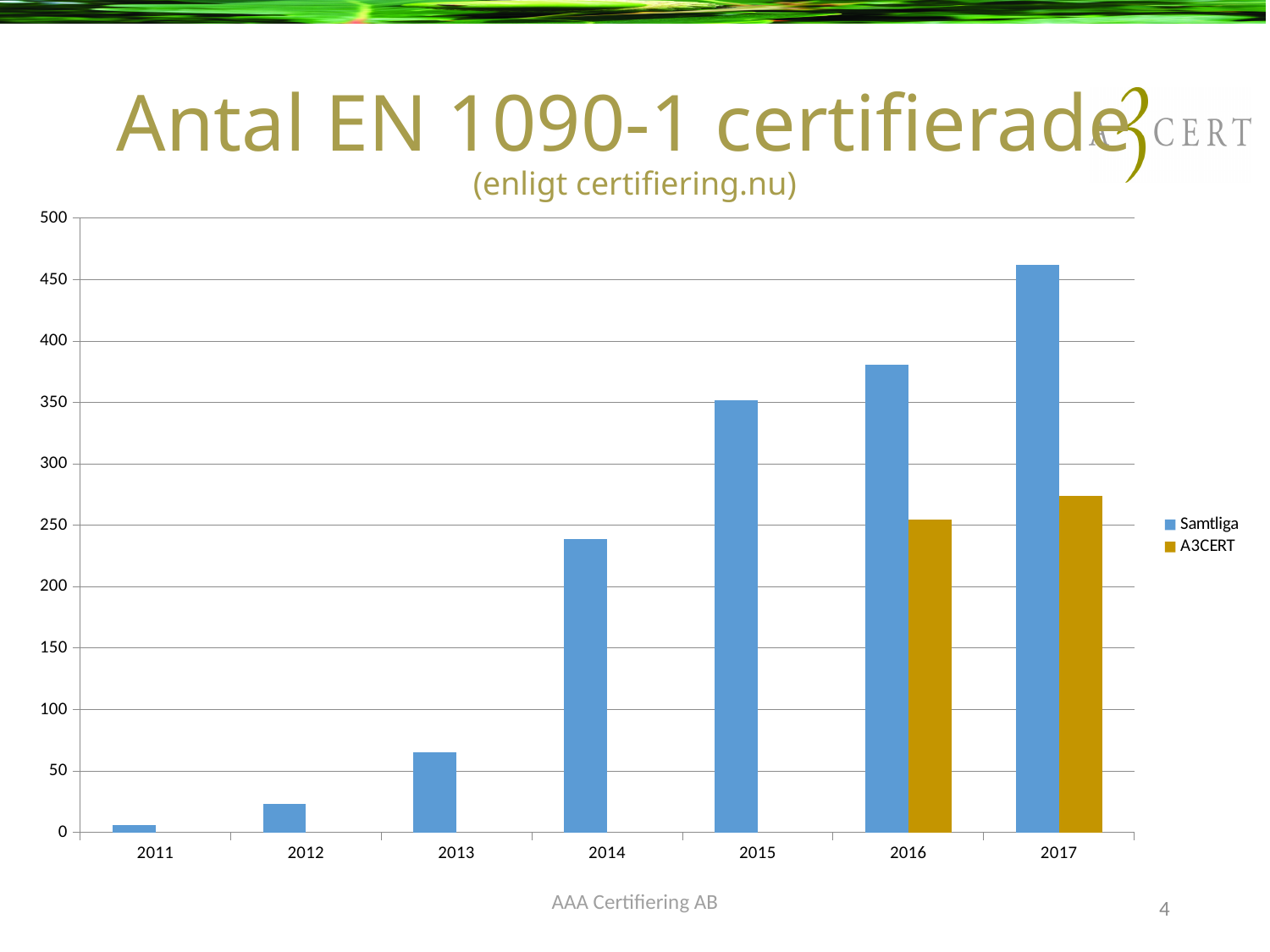
Is the Samtliga value for 2015 greater or less than 300? greater How many years are shown on the x axis? 7 Is the Samtliga value for 2014 greater or less than 250? less In which year is the Samtliga value lowest? 2011 Is the Samtliga value for 2013 greater or less than 100? less How many series does the legend list? 2 In which year is the Samtliga value highest? 2017 Do the Samtliga values rise or fall from 2011 to 2017? rise What kind of chart is shown on the slide? bar chart In 2016, which series has the larger value, Samtliga or A3CERT? Samtliga What are the two entries listed in the legend? Samtliga and A3CERT